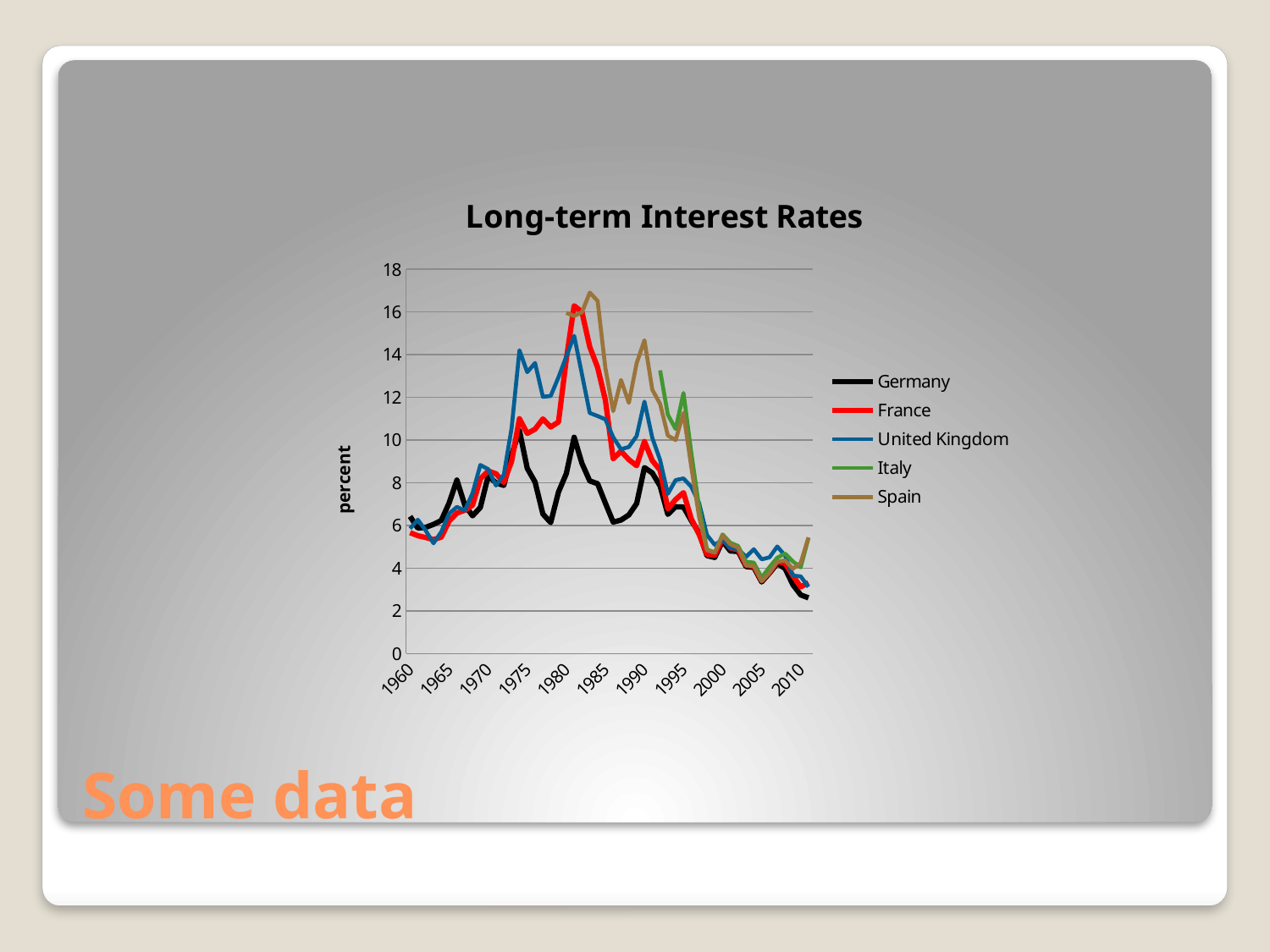
Is the value for Germany in 2010 greater or less than 4? less Is the value for Germany in 1978 greater or less than 8? less What kind of chart is shown on the slide? line chart Which series has the highest value in 1975? United Kingdom What is the label on the vertical axis? percent Is the value for the United Kingdom in 1975 greater or less than 12? greater Which series has the lowest value around 1978? Germany Do the values for France rise or fall between 1995 and 2010? fall What is the title of the chart? Long-term Interest Rates In 1975, which is larger, the value for the United Kingdom or the value for Germany? United Kingdom Around 1982, which is larger, the value for France or the value for Germany? France How many series does the legend list? 5